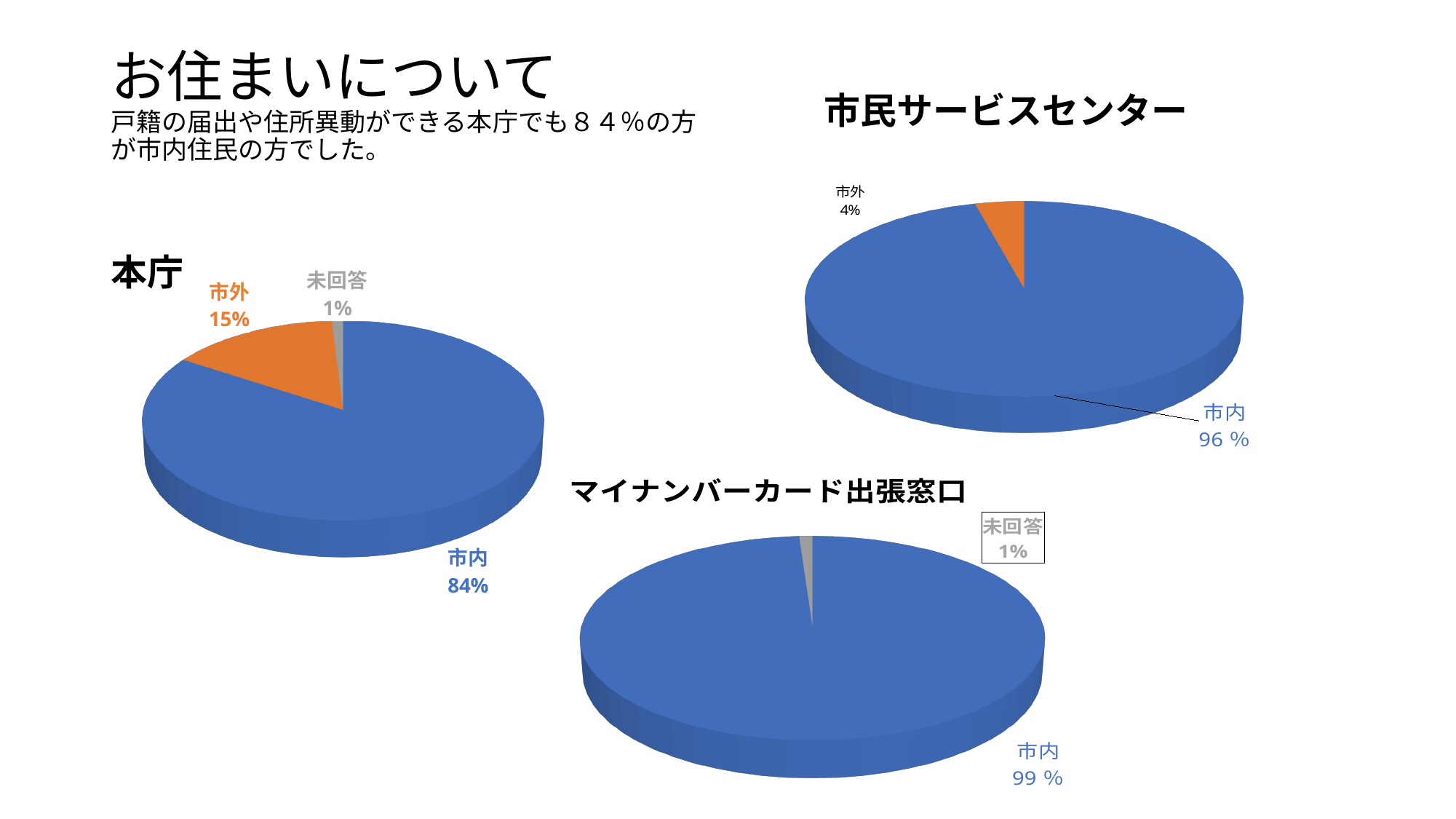
How many slices does the 本庁 pie chart have? 3 What kind of chart is used for 市民サービスセンター? Pie chart In the 市民サービスセンター chart, what share is labelled for 市内? 96 % In the 本庁 chart, which category has the largest slice? 市内 In the マイナンバーカード出張窓口 chart, what share is labelled for 市内? 99 % In the 本庁 chart, what is the difference between the 市外 share and the 未回答 share? 14% In the 本庁 chart, which category has the smallest slice? 未回答 In the 本庁 chart, what share is labelled for 未回答? 1% In the 本庁 chart, what share is labelled for 市内? 84% In the 市民サービスセンター chart, what share is labelled for 市外? 4% In the マイナンバーカード出張窓口 chart, what share is labelled for 未回答? 1% In the 本庁 chart, what share is labelled for 市外? 15%